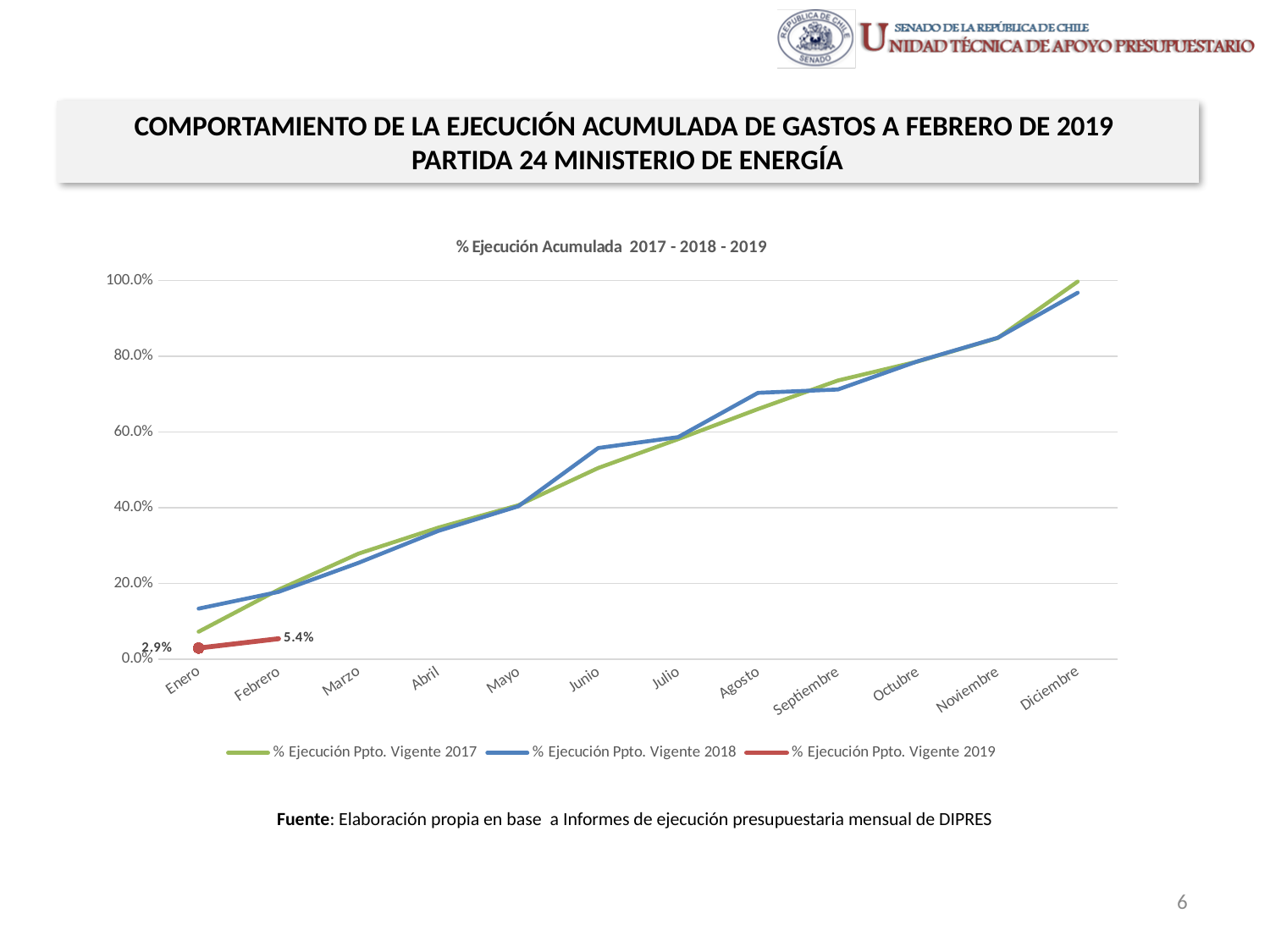
What kind of chart is shown on the slide? Line chart Is the value for % Ejecución Ppto. Vigente 2018 in Junio greater or less than 40.0%? greater What is the title of the chart? % Ejecución Acumulada 2017 - 2018 - 2019 Does the % Ejecución Ppto. Vigente 2017 line rise or fall from Enero to Diciembre? Rise In which month does % Ejecución Ppto. Vigente 2017 reach its highest value? Diciembre In Enero, which series is higher: % Ejecución Ppto. Vigente 2017 or % Ejecución Ppto. Vigente 2018? % Ejecución Ppto. Vigente 2018 What is the value of % Ejecución Ppto. Vigente 2019 for Febrero? 5.4% By how many percentage points did % Ejecución Ppto. Vigente 2019 increase from Enero to Febrero? 2.5% Is the value for % Ejecución Ppto. Vigente 2018 in Enero greater or less than 20.0%? less How many series does the legend list? 3 How many months are shown on the x axis? 12 What is the value of % Ejecución Ppto. Vigente 2019 for Enero? 2.9%